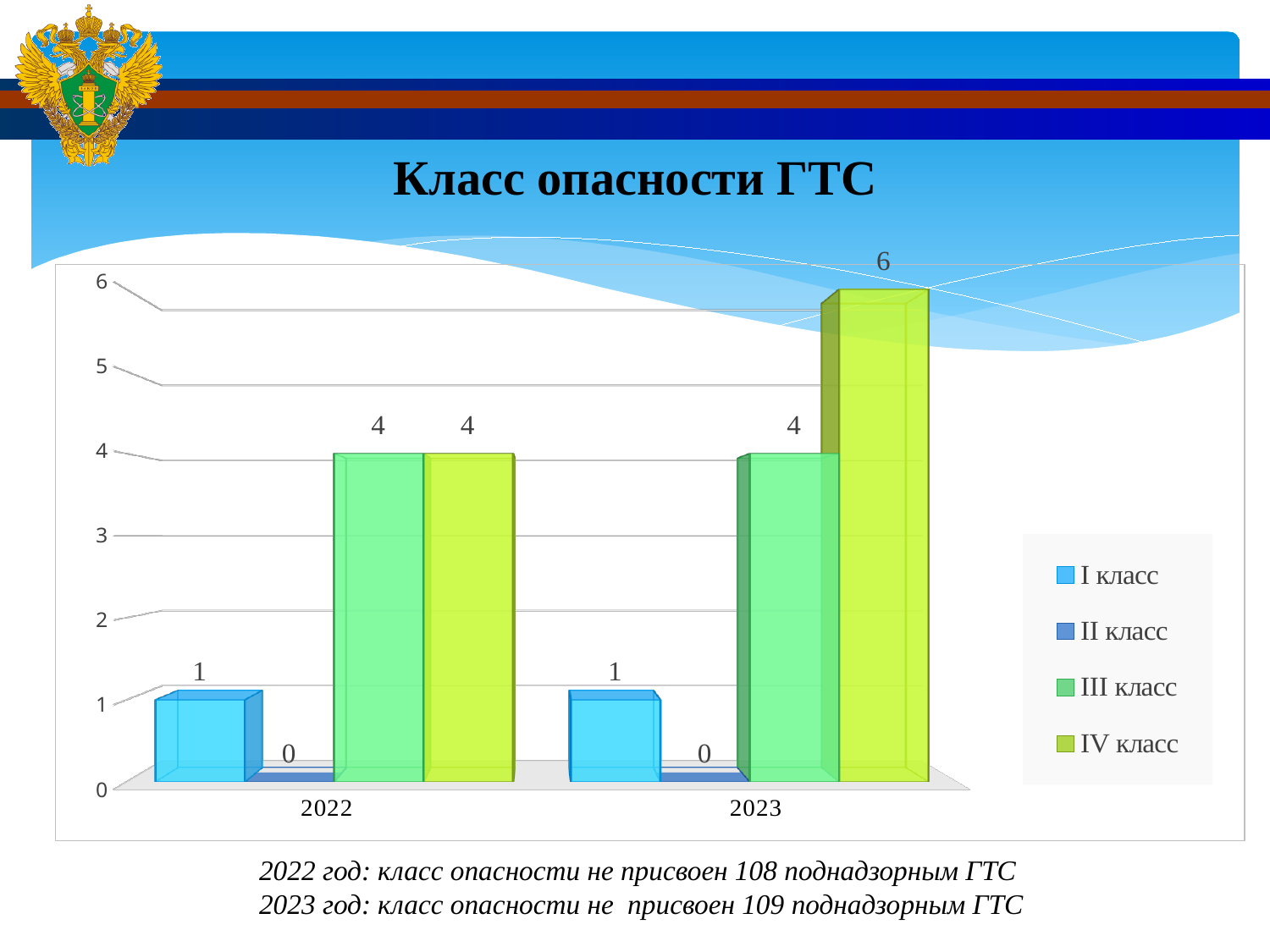
What is the value for III класс in 2022? 4 Which is larger: the value for III класс in 2023 or the value for I класс in 2023? III класс in 2023 Which series has the lowest value in 2022? II класс What kind of chart is shown on the slide? Bar chart What is the title of the chart? Класс опасности ГТС What is the value for II класс in 2022? 0 How many series does the legend list? 4 What is the value for I класс in 2023? 1 Which series has the highest value in 2023? IV класс What is the difference between the IV класс values for 2023 and 2022? 2 How many categories are shown on the x axis? 2 What is the value for IV класс in 2023? 6